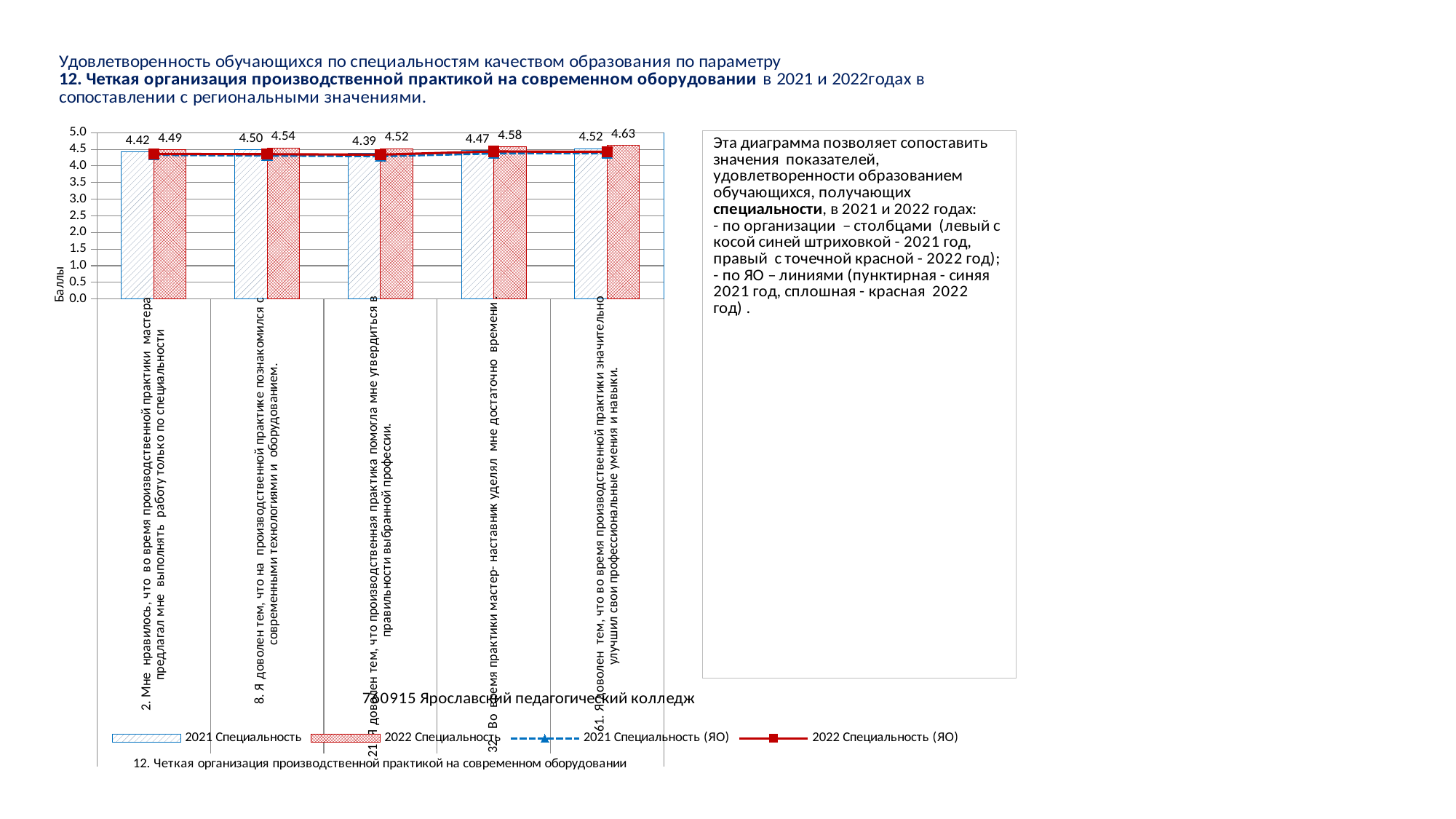
Which is larger for item 8: the 2021 Специальность value or the 2022 Специальность value? 2022 Специальность (4.54) What is the difference between the 2022 and 2021 Специальность values for item 21? 0.13 How many series does the chart legend list? 4 What is the label of the vertical axis of the chart? Баллы What is the value of the 2021 Специальность bar for item 32 (Во время практики мастер-наставник уделял мне достаточно времени)? 4.47 How many items (categories) are shown on the x axis of the chart? 5 Which item has the lowest 2021 Специальность value? 21. Я доволен тем, что производственная практика помогла мне утвердиться в правильности выбранной профессии What is the value of the 2022 Специальность bar for item 21 (Я доволен тем, что производственная практика помогла мне утвердиться в правильности выбранной профессии)? 4.52 Is the 2021 Специальность value for item 2 greater or less than 4.0? greater What is the value of the 2021 Специальность bar for item 2 (Мне нравилось, что во время производственной практики мастера предлагал мне выполнять работу только по специальности)? 4.42 Which item has the highest 2022 Специальность value? 61. Я доволен тем, что во время производственной практики значительно улучшил свои профессиональные умения и навыки What is the value of the 2022 Специальность bar for item 61 (Я доволен тем, что во время производственной практики значительно улучшил свои профессиональные умения и навыки)? 4.63